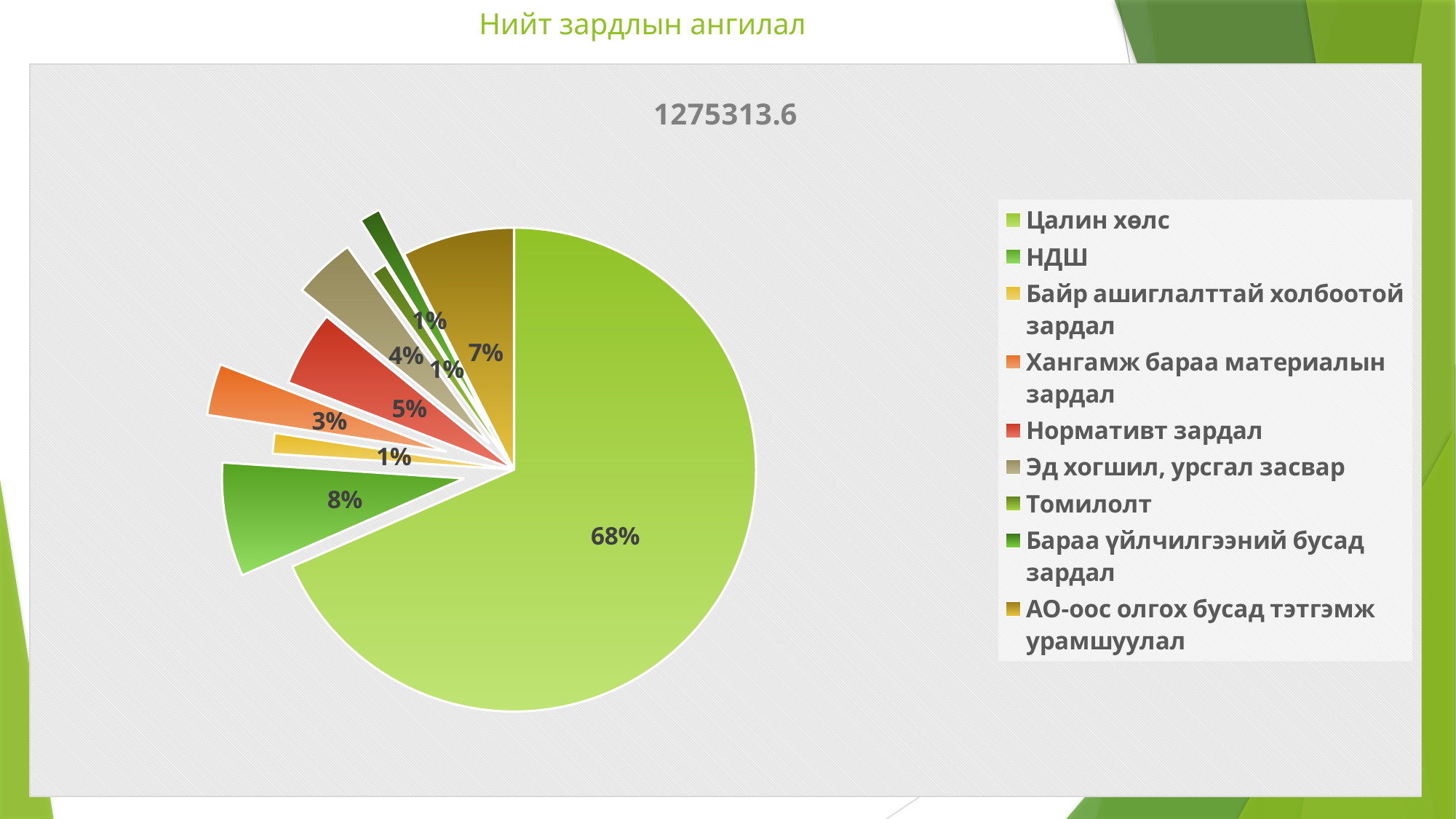
How many slices does the pie chart have? 9 Which category has the largest slice of the pie? Цалин хөлс What is the difference in percentage points between the Цалин хөлс slice and the НДШ slice? 60 What share of the pie does Нормативт зардал take? 5% What share of the pie does Цалин хөлс take? 68% What is the title shown above the pie chart? 1275313.6 What share of the pie does Хангамж бараа материалын зардал take? 3% What kind of chart is shown on the slide? pie chart How many entries does the legend list? 9 Which is larger, the slice for НДШ or the slice for Нормативт зардал? НДШ